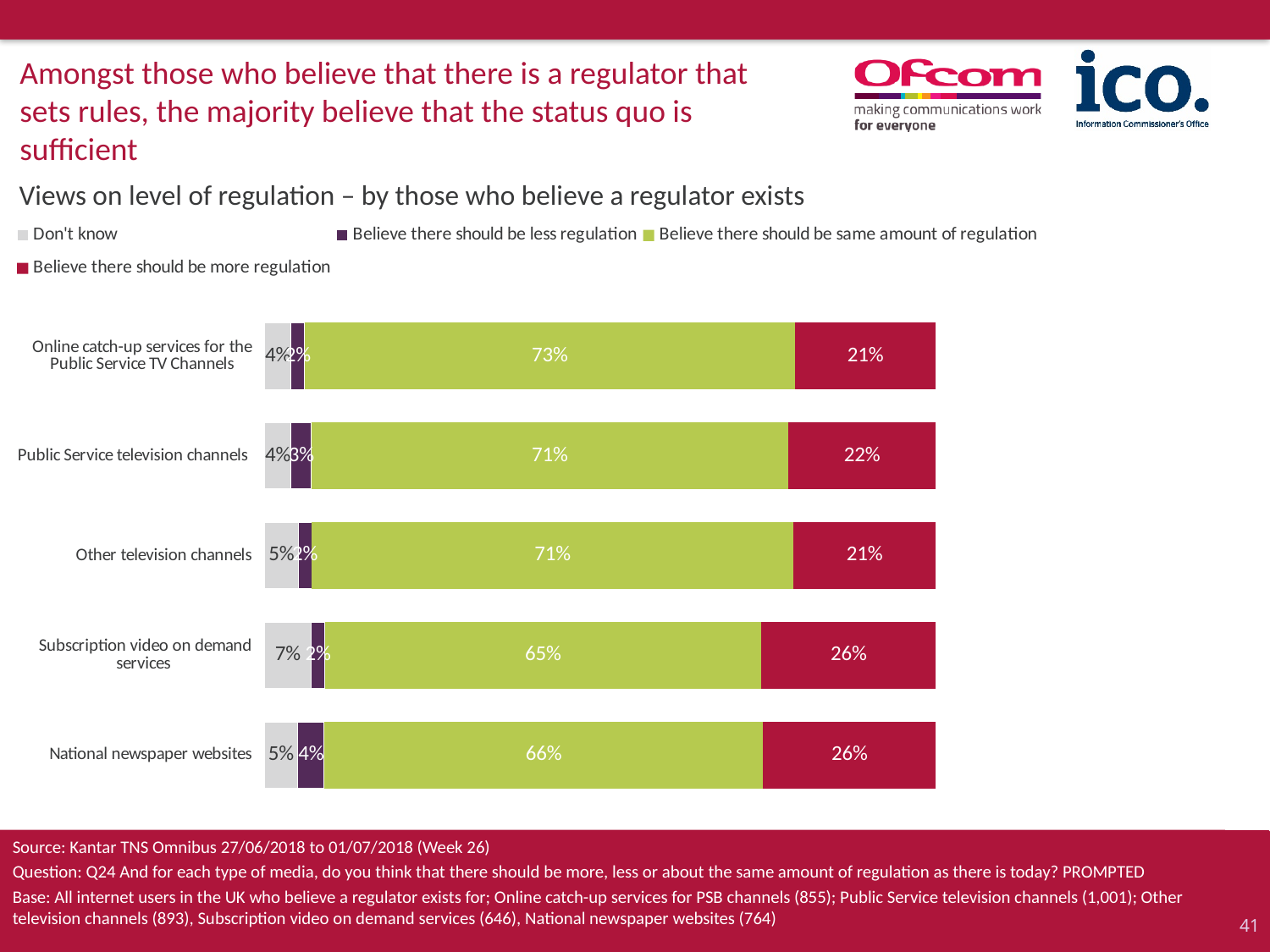
Which media type has the lowest share believing there should be the same amount of regulation? Subscription video on demand services What percentage believe there should be more regulation for National newspaper websites? 26% What percentage believe there should be more regulation for Subscription video on demand services? 26% How many series does the legend list? 4 What colour represents 'Believe there should be more regulation' in the chart? Red What percentage of those who believe a regulator exists think there should be the same amount of regulation for Online catch-up services for the Public Service TV Channels? 73% What is the 'Don't know' percentage for Subscription video on demand services? 7% Which has a larger 'Don't know' share: Subscription video on demand services or Public Service television channels? Subscription video on demand services How many media types (categories) are shown in the chart? 5 What kind of chart is shown on the slide? Stacked bar chart What is the difference in percentage points between the 'same amount of regulation' share for Online catch-up services for the Public Service TV Channels and for Subscription video on demand services? 8 percentage points Which media type has the highest share believing there should be the same amount of regulation? Online catch-up services for the Public Service TV Channels